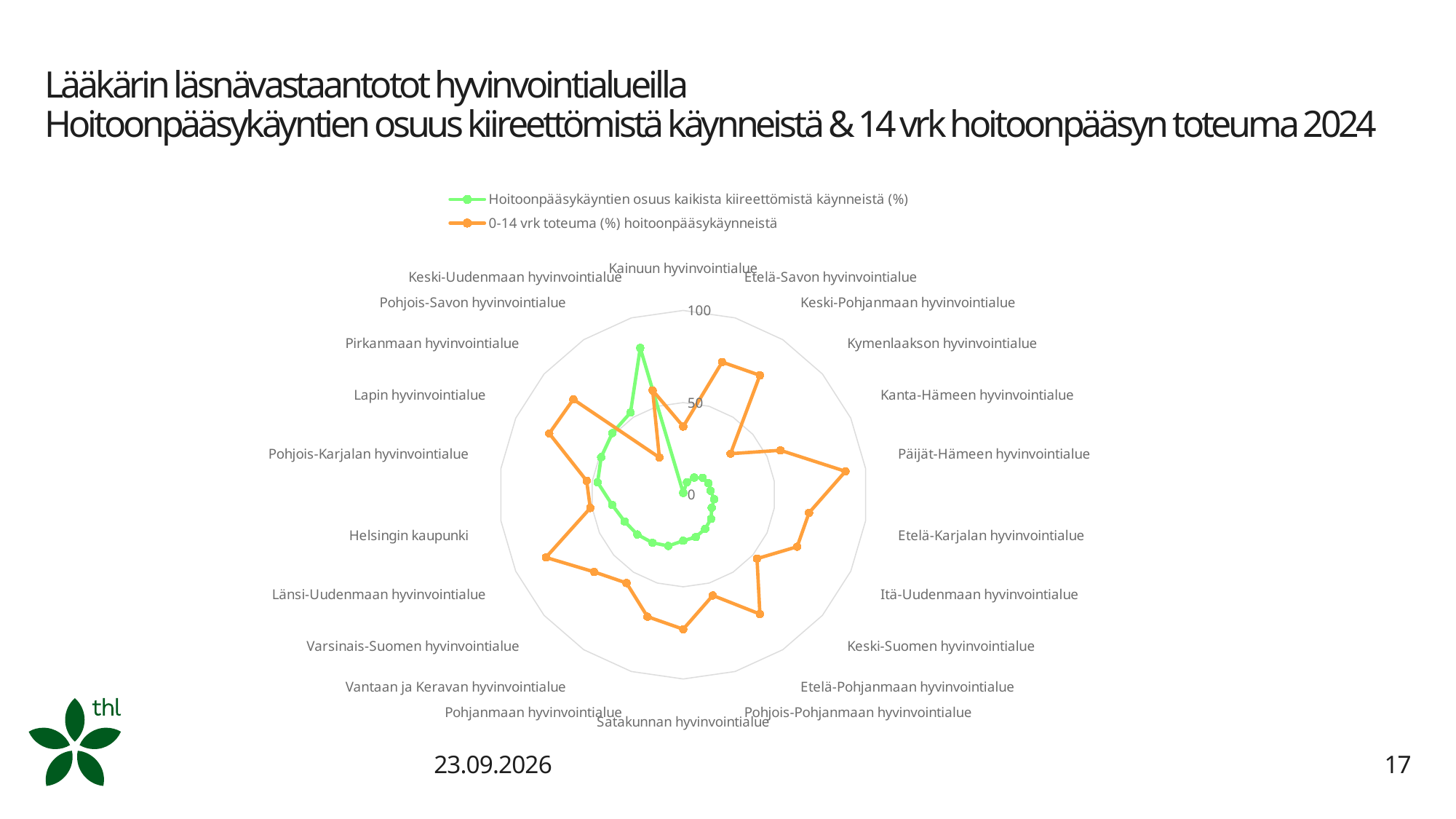
For Päijät-Hämeen hyvinvointialue, which series has the larger value: the green Hoitoonpääsykäyntien osuus series or the orange 0-14 vrk toteuma series? 0-14 vrk toteuma (%) hoitoonpääsykäynneistä Is the 0-14 vrk toteuma (%) value for Kymenlaakson hyvinvointialue greater or less than 50? less Is the 0-14 vrk toteuma (%) value for Länsi-Uudenmaan hyvinvointialue greater or less than 50? greater Is the 0-14 vrk toteuma (%) value for Kainuun hyvinvointialue greater or less than 50? less Which hyvinvointialue has the highest Hoitoonpääsykäyntien osuus kaikista kiireettömistä käynneistä (%) value? Keski-Uudenmaan hyvinvointialue Which series is drawn in orange according to the legend? 0-14 vrk toteuma (%) hoitoonpääsykäynneistä How many hyvinvointialue categories are plotted around the radar chart? 22 Which series is drawn in green according to the legend? Hoitoonpääsykäyntien osuus kaikista kiireettömistä käynneistä (%) How many series does the legend list? 2 What kind of chart is shown on the slide? radar chart